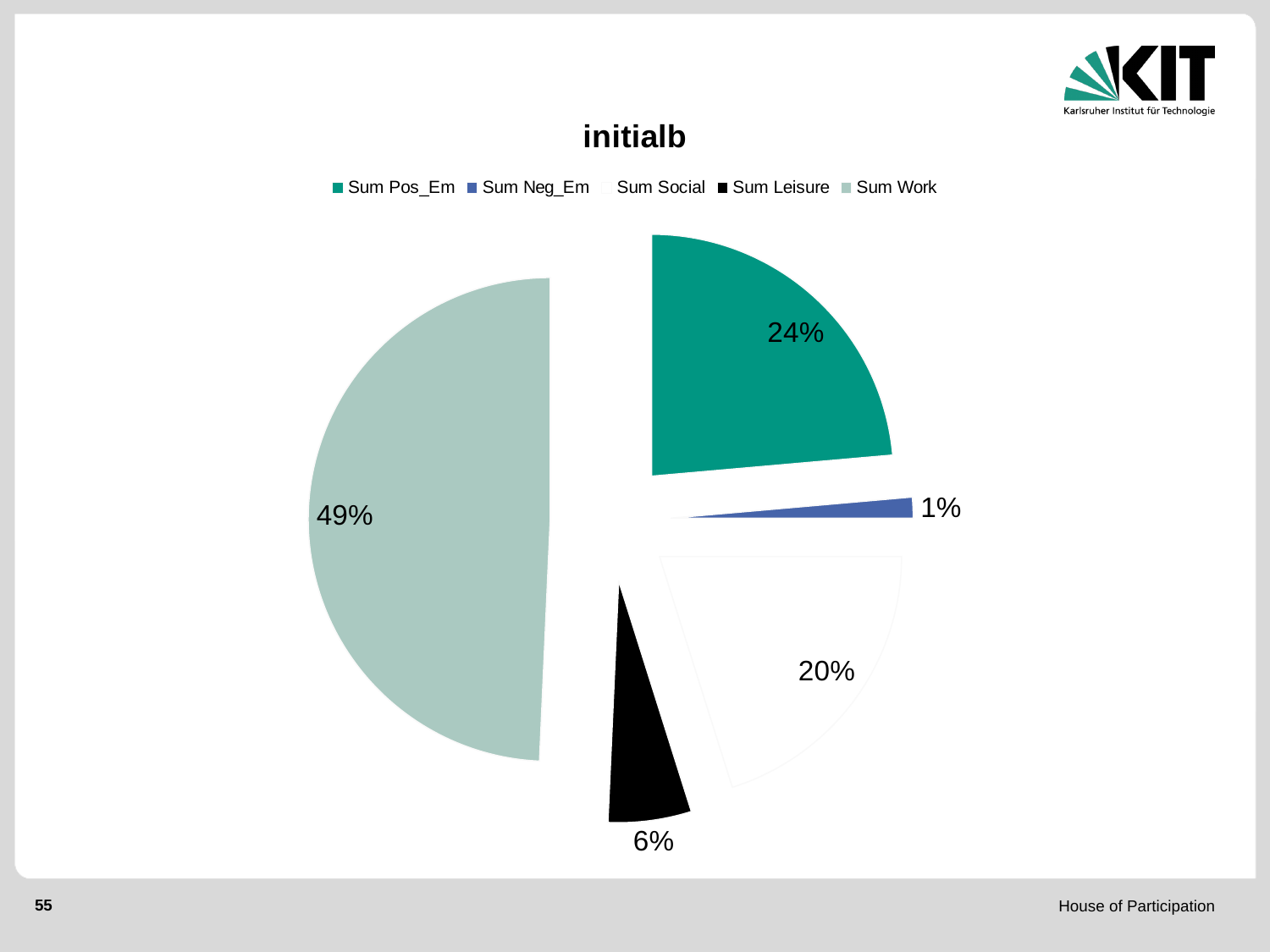
What share of the pie is Sum Social? 20% How many entries does the legend list? 5 Which category has the smallest slice? Sum Neg_Em What share of the pie is Sum Neg_Em? 1% What is the difference in percentage points between Sum Work and Sum Pos_Em? 25 What share of the pie is Sum Pos_Em? 24% Which category has the largest slice? Sum Work What kind of chart is shown on the slide? pie chart How many slices does the pie chart have? 5 What is the title of the chart? initialb